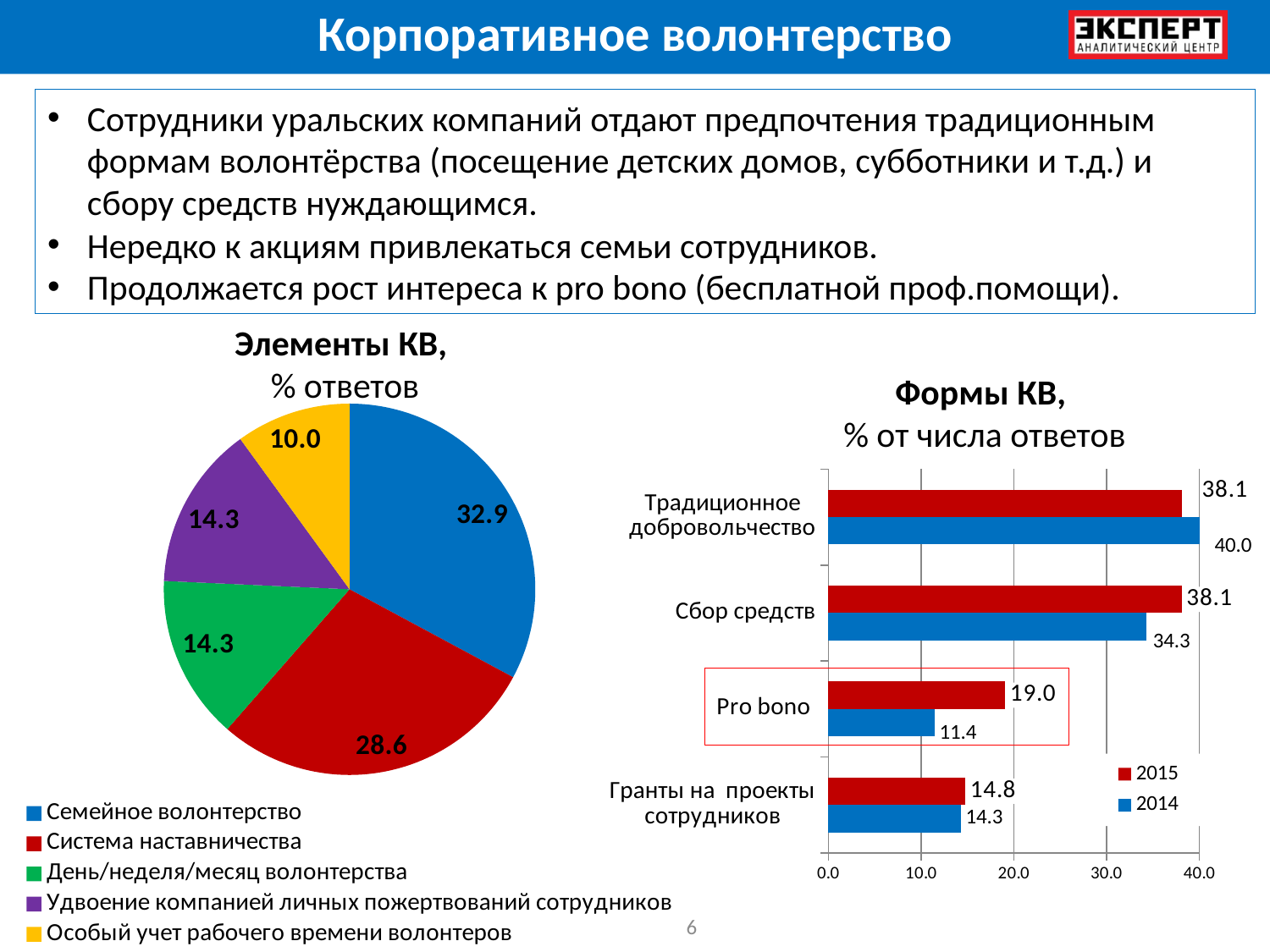
In the pie chart 'Элементы КВ', which category has the largest slice? Семейное волонтерство In the bar chart 'Формы КВ', what is the 2014 value for Традиционное добровольчество? 40.0 What kind of chart is 'Формы КВ'? Bar chart In the pie chart 'Элементы КВ', which category has the smallest slice? Особый учет рабочего времени волонтеров In the bar chart 'Формы КВ', which category has the lowest 2014 value? Pro bono In the bar chart 'Формы КВ', what is the 2015 value for Pro bono? 19.0 In the bar chart 'Формы КВ', how many series does the legend list? 2 In the bar chart 'Формы КВ', what is the difference between the 2015 and 2014 values for Pro bono? 7.6 In the pie chart 'Элементы КВ', what is the difference between Семейное волонтерство and Система наставничества? 4.3 In the bar chart 'Формы КВ', which is larger for Сбор средств: the 2015 value or the 2014 value? 2015 In the pie chart 'Элементы КВ', what is the value for Семейное волонтерство? 32.9 In the pie chart 'Элементы КВ', how many slices are there? 5